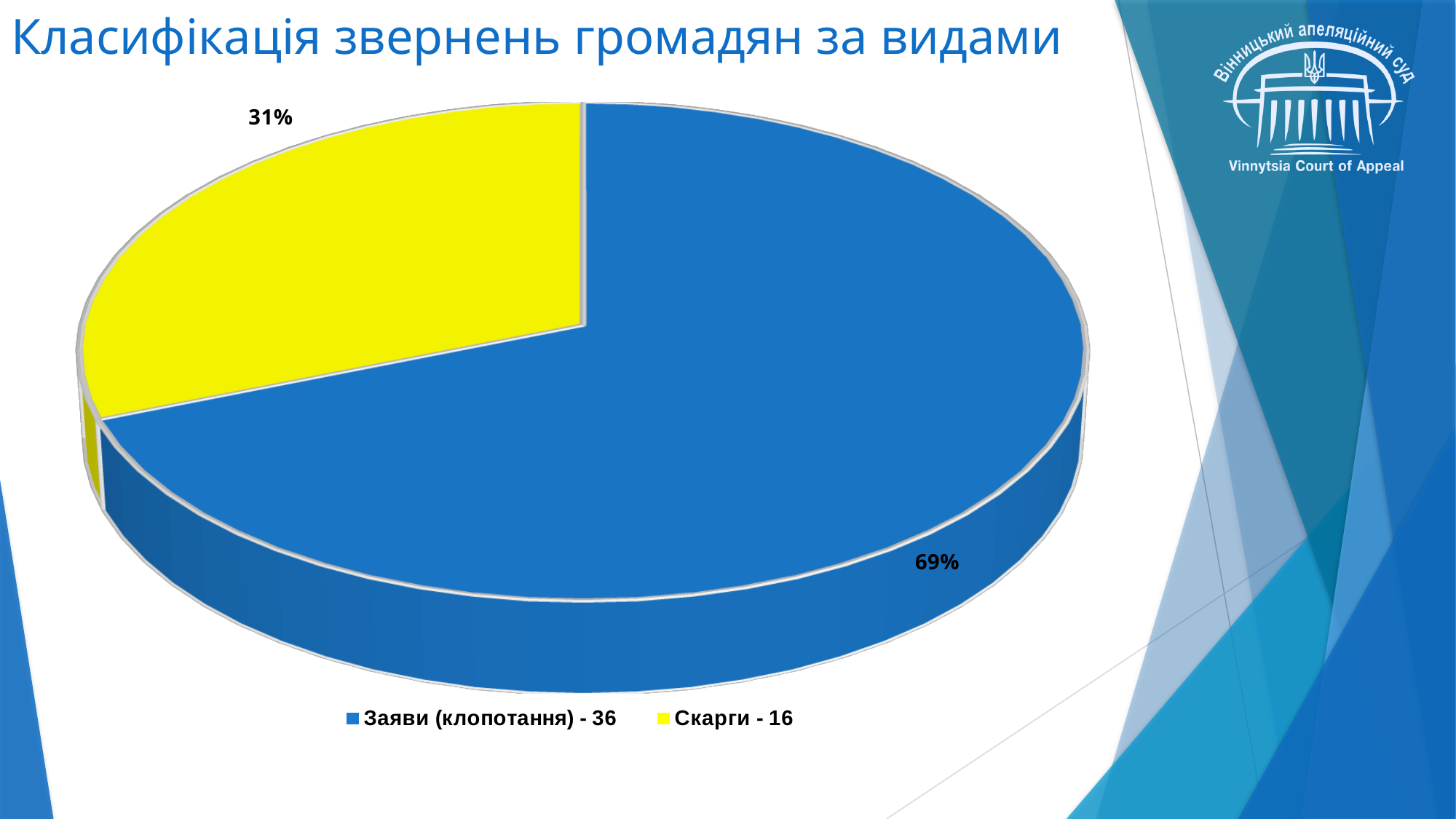
Which category has the smallest slice of the pie? Скарги What is the title of the chart? Класифікація звернень громадян за видами What kind of chart is shown on the slide? pie chart What percentage share does the slice for Заяви (клопотання) have? 69% Which colour represents Скарги in the pie chart? yellow Which category has the largest slice of the pie? Заяви (клопотання) What count is given in the legend for Заяви (клопотання)? 36 How many slices does the pie chart have? 2 What count is given in the legend for Скарги? 16 What percentage share does the slice for Скарги have? 31% How many entries does the legend list? 2 What is the difference between the counts for Заяви (клопотання) and Скарги? 20